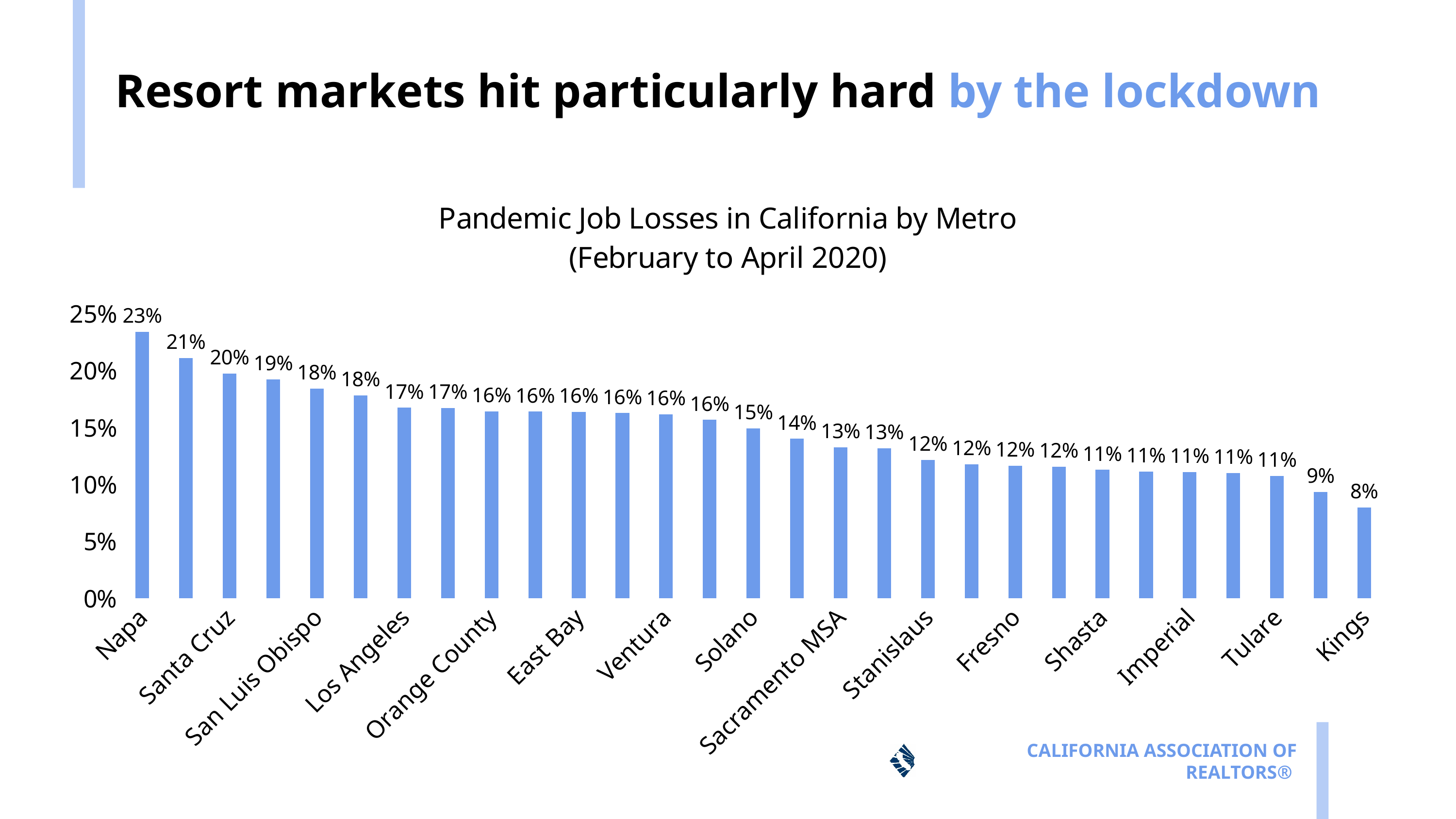
What is the title of the chart? Pandemic Job Losses in California by Metro (February to April 2020) Which metro has the lowest pandemic job loss percentage? Kings What is the pandemic job loss percentage for Napa? 23% What kind of chart is shown on the slide? Bar chart Which has a larger job loss percentage, Santa Cruz or Fresno? Santa Cruz Do the values rise or fall moving from left to right along the x axis? Fall What is the job loss percentage shown for Santa Cruz? 20% What is the difference in percentage points between Napa's and Kings' job losses? 15 percentage points What is the pandemic job loss percentage for Kings? 8% What is the job loss percentage shown for Solano? 15% Which metro has the highest pandemic job loss percentage? Napa What is the job loss percentage shown for Sacramento MSA? 13%